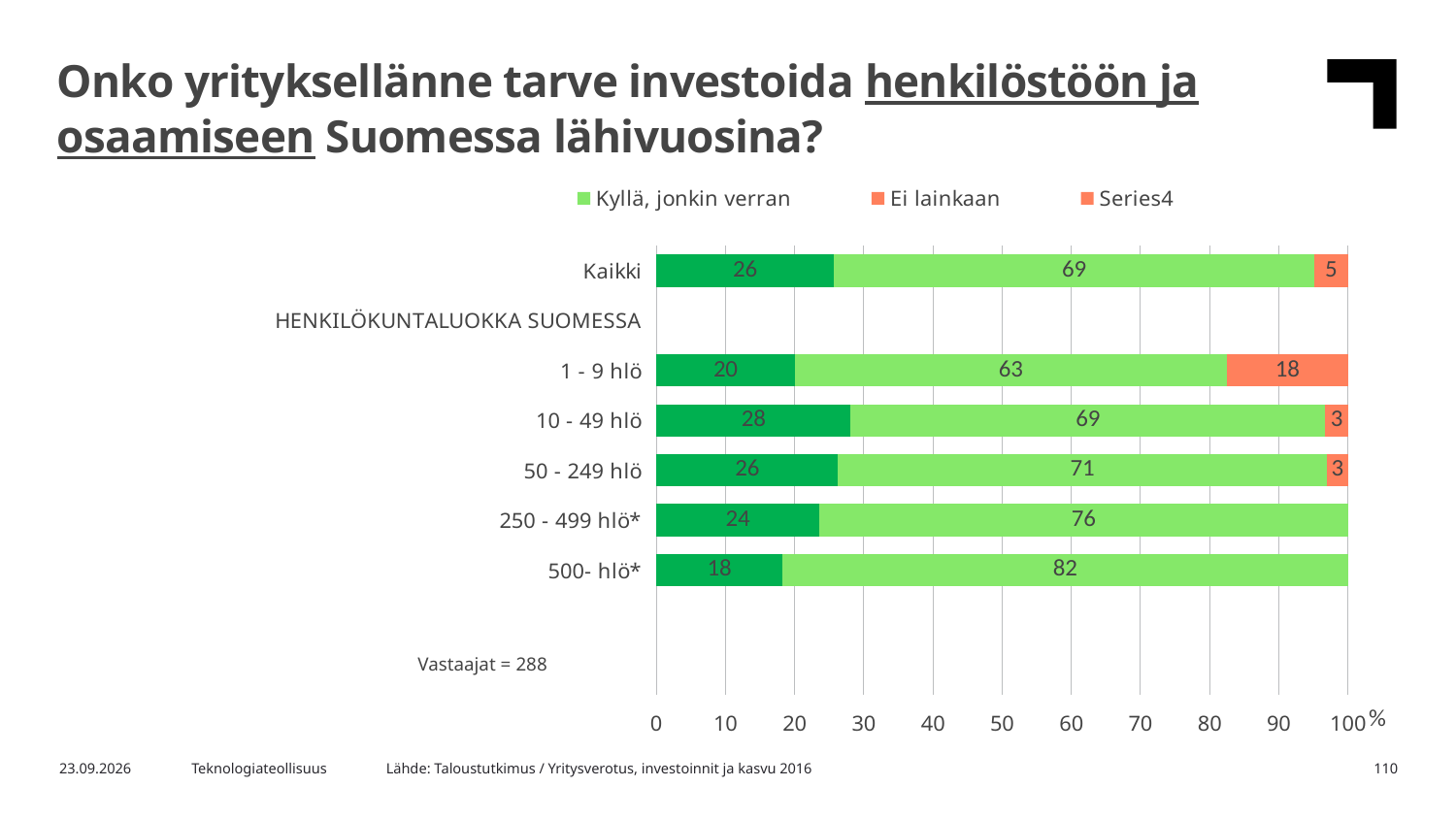
How many bars (categories with data) are plotted in the chart? 6 How many series does the legend list? 3 What is the value of "Kyllä, jonkin verran" for the 500- hlö* category? 82 Which category has the highest value for "Kyllä, jonkin verran"? 500- hlö* Which category has the highest value for "Ei lainkaan"? 1 - 9 hlö What is the value of "Ei lainkaan" for the Kaikki category? 5 What is the value of "Ei lainkaan" for the 1 - 9 hlö category? 18 What is the difference between the "Kyllä, jonkin verran" values for 500- hlö* and 1 - 9 hlö? 19 What is the value of "Kyllä, jonkin verran" for the Kaikki category? 69 Which is larger: the "Kyllä, jonkin verran" value for 50 - 249 hlö or for 10 - 49 hlö? 50 - 249 hlö What kind of chart is shown on the slide? Stacked bar chart Which category has the lowest value for "Kyllä, jonkin verran"? 1 - 9 hlö